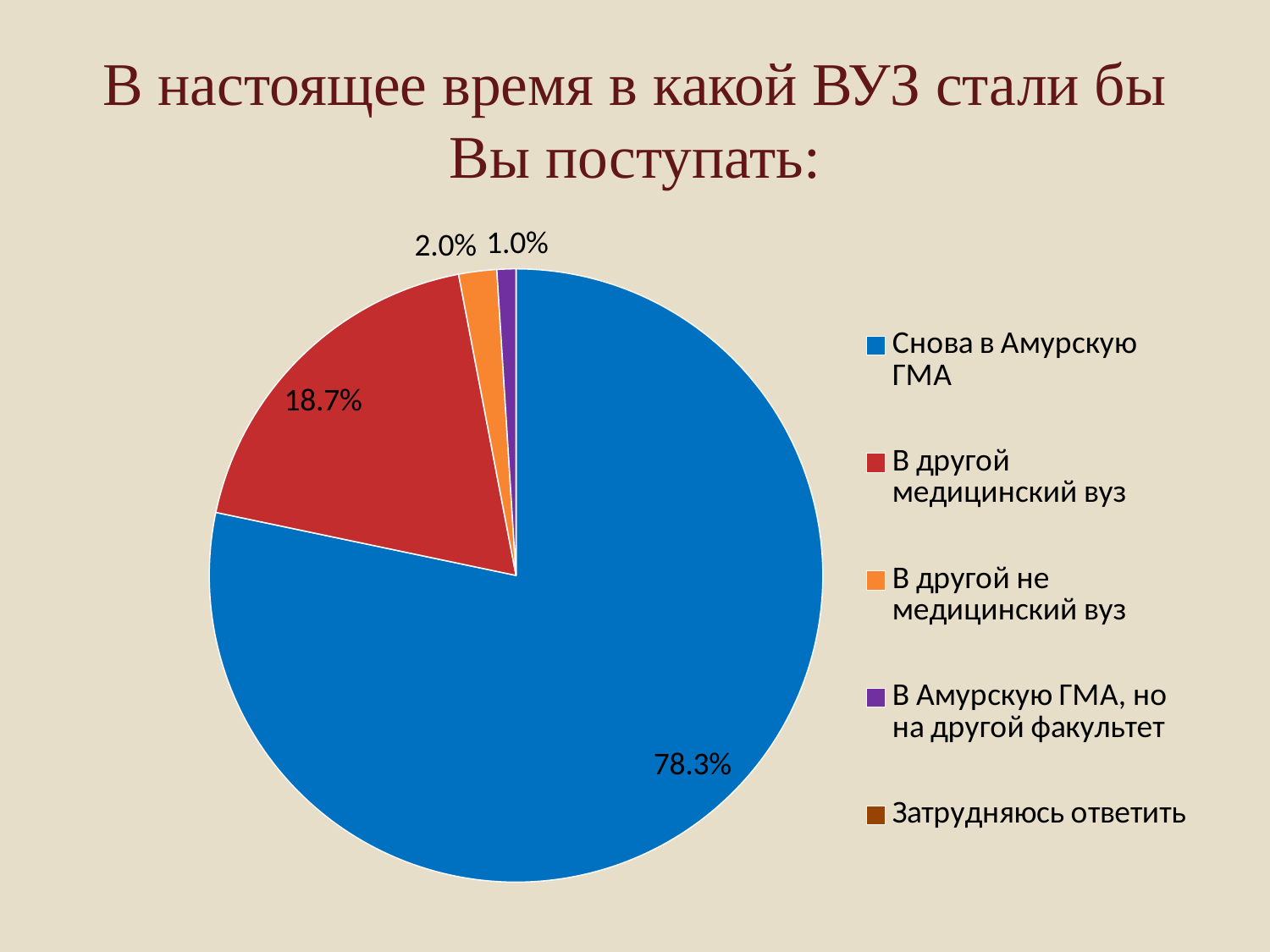
What is the difference in percentage points between "Снова в Амурскую ГМА" and "В другой медицинский вуз"? 59.6 What kind of chart is shown on the slide? Pie chart Which is larger: the slice for "В другой не медицинский вуз" or the slice for "В Амурскую ГМА, но на другой факультет"? В другой не медицинский вуз What share of the pie does "В Амурскую ГМА, но на другой факультет" have? 1.0% What colour is the slice for "В другой медицинский вуз"? Red What share of the pie does "В другой не медицинский вуз" have? 2.0% What is the title of the chart? В настоящее время в какой ВУЗ стали бы Вы поступать: Which category has the largest slice of the pie? Снова в Амурскую ГМА What share of the pie does "В другой медицинский вуз" have? 18.7% What share of the pie does "Снова в Амурскую ГМА" have? 78.3% Which labelled slice of the pie is the smallest? В Амурскую ГМА, но на другой факультет How many entries does the legend list? 5